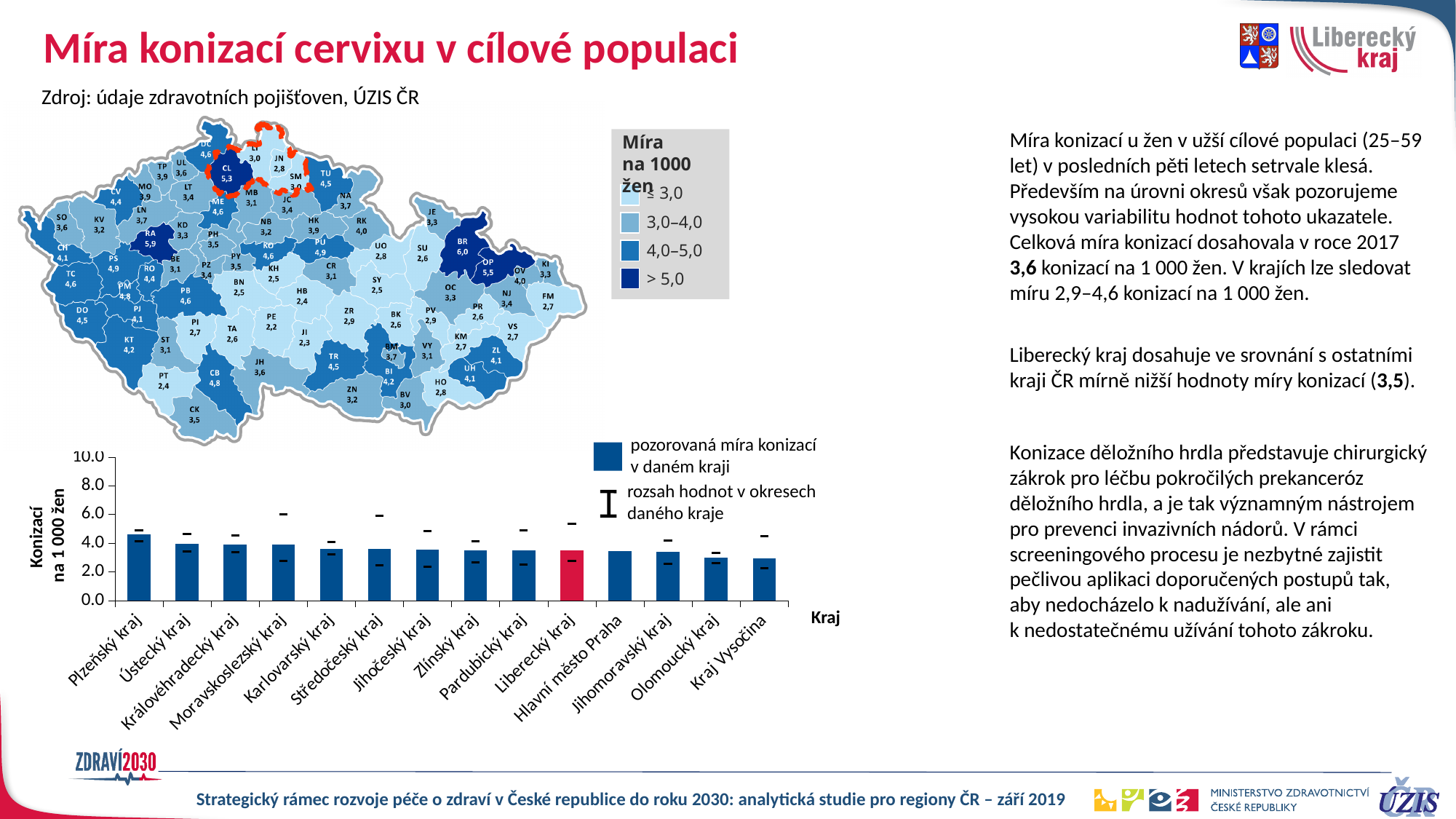
How many regions (kraje) are shown on the x axis of the bar chart? 14 In the bar chart, which has a higher value: Plzeňský kraj or Kraj Vysočina? Plzeňský kraj Which region's bar is highlighted in red in the bar chart? Liberecký kraj What is the label of the y axis of the bar chart? Konizací na 1 000 žen In the bar chart, is the value for Liberecký kraj greater or less than 4.0? less In the bar chart, which region has the highest observed conization rate? Plzeňský kraj In the bar chart, is the value for Olomoucký kraj greater or less than 4.0? less What kind of chart is shown at the bottom left of the slide? bar chart In the bar chart, is the value for Kraj Vysočina greater or less than 4.0? less In the bar chart, do the bar values rise or fall from left to right along the x axis? fall